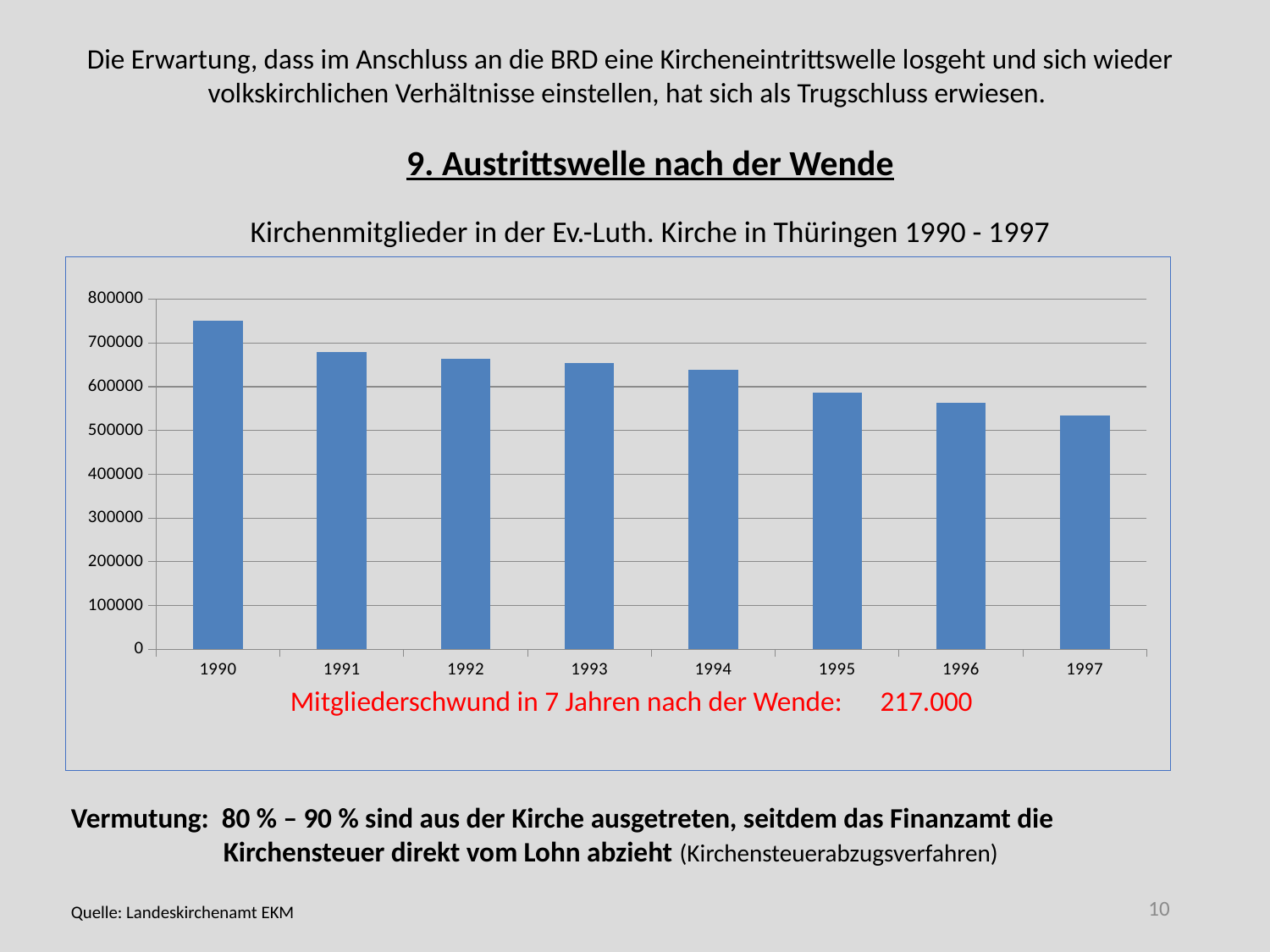
Which year has the lowest number of church members? 1997 What is the title of the chart? Kirchenmitglieder in der Ev.-Luth. Kirche in Thüringen 1990 - 1997 Which is larger, the value for 1991 or the value for 1995? 1991 According to the red text in the chart, what is the membership loss in the 7 years after the Wende? 217.000 What kind of chart is shown on the slide? bar chart Is the value for 1990 greater or less than 700000? greater Do the values rise or fall from 1990 to 1997? fall Is the value for 1995 greater or less than 600000? less Is the value for 1997 greater or less than 500000? greater Which year has the highest number of church members? 1990 How many years are shown on the x axis of the chart? 8